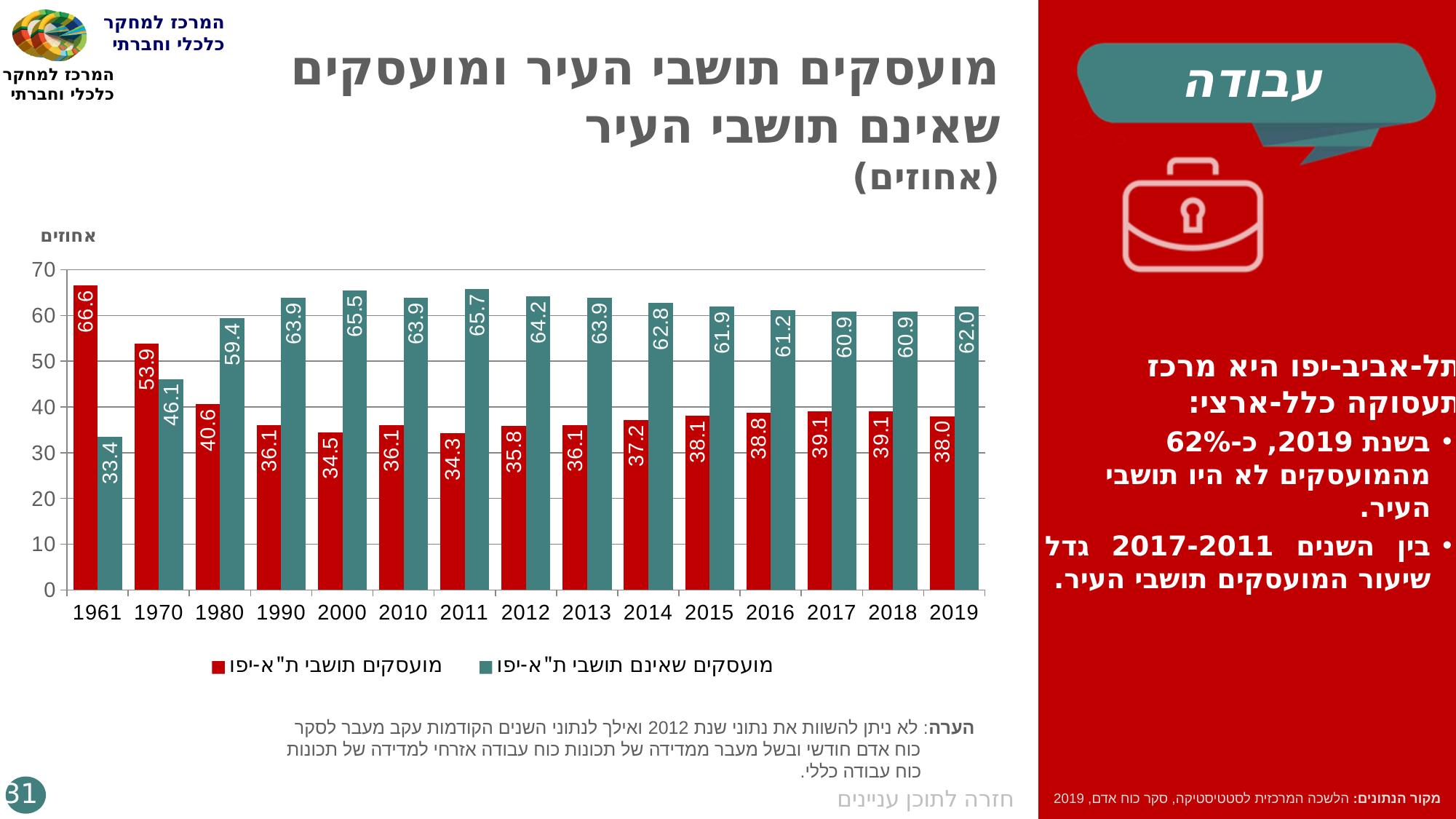
What is the value for מועסקים תושבי ת"א-יפו in 1961? 66.6 What is the difference between the value for מועסקים שאינם תושבי ת"א-יפו and מועסקים תושבי ת"א-יפו in 2019? 24.0 In which year is the value for מועסקים תושבי ת"א-יפו the lowest? 2011 In which year is the value for מועסקים שאינם תושבי ת"א-יפו the highest? 2011 How many series does the legend list? 2 Which series has the larger value in 1970, מועסקים תושבי ת"א-יפו or מועסקים שאינם תושבי ת"א-יפו? מועסקים תושבי ת"א-יפו What type of chart is shown on the slide? bar chart What is the value for מועסקים שאינם תושבי ת"א-יפו in 2019? 62.0 Which colour represents מועסקים תושבי ת"א-יפו in the chart? red How many years are shown on the x axis of the chart? 15 What is the value for מועסקים תושבי ת"א-יפו in 2011? 34.3 Does the value for מועסקים תושבי ת"א-יפו rise or fall from 1961 to 1990? fall